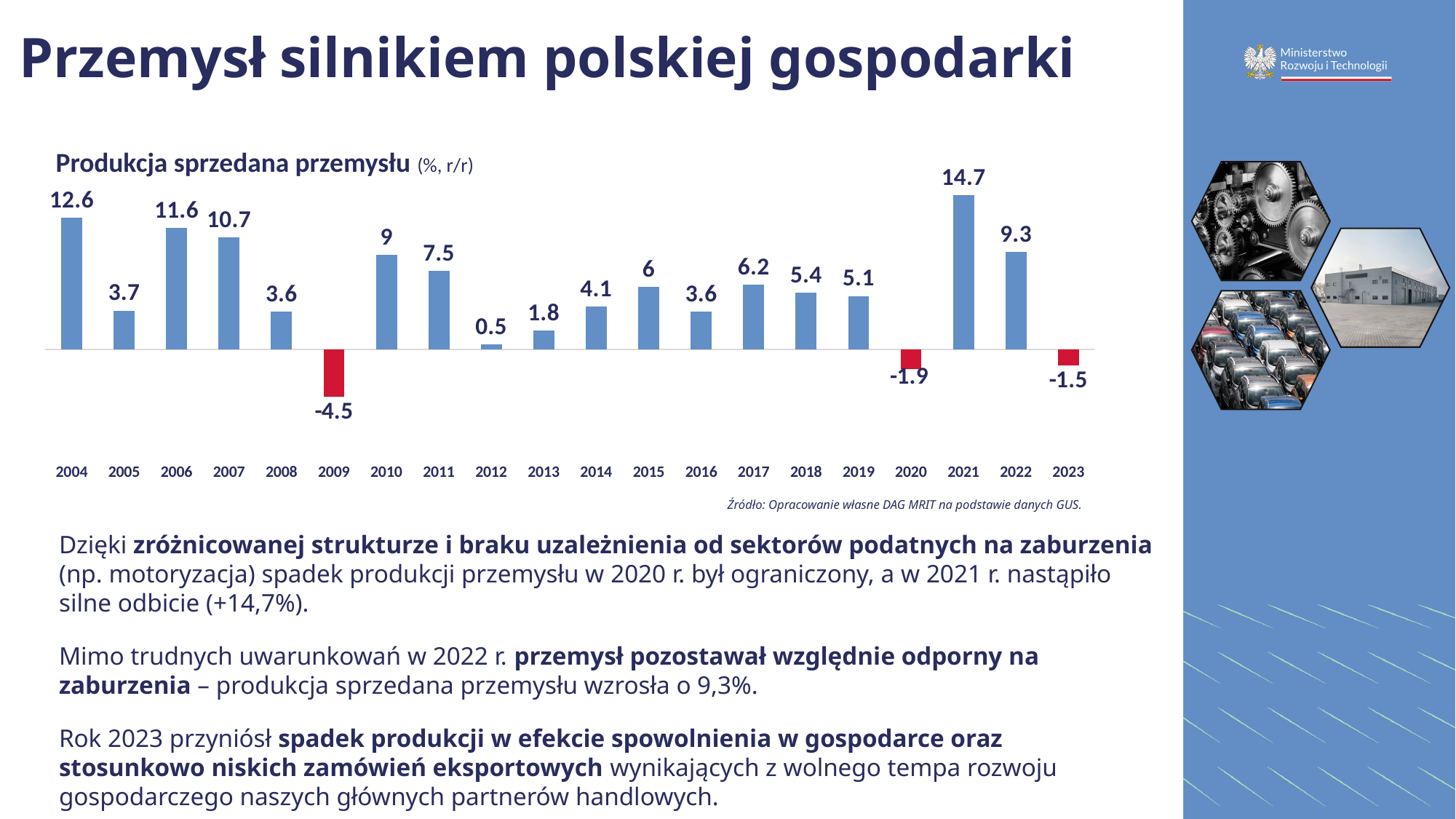
Which year has the lowest value? 2009 What is the value for 2023? -1.5 Do the values rise or fall from 2021 to 2023? fall Which is larger, the value for 2006 or the value for 2007? 2006 What colour are the bars with negative values? red What kind of chart is this? bar chart Which year has the highest value? 2021 What is the title of the chart? Produkcja sprzedana przemysłu (%, r/r) What is the value for 2009? -4.5 How many years are shown on the x axis? 20 What is the difference between the values for 2021 and 2022? 5.4 What is the value for 2021? 14.7